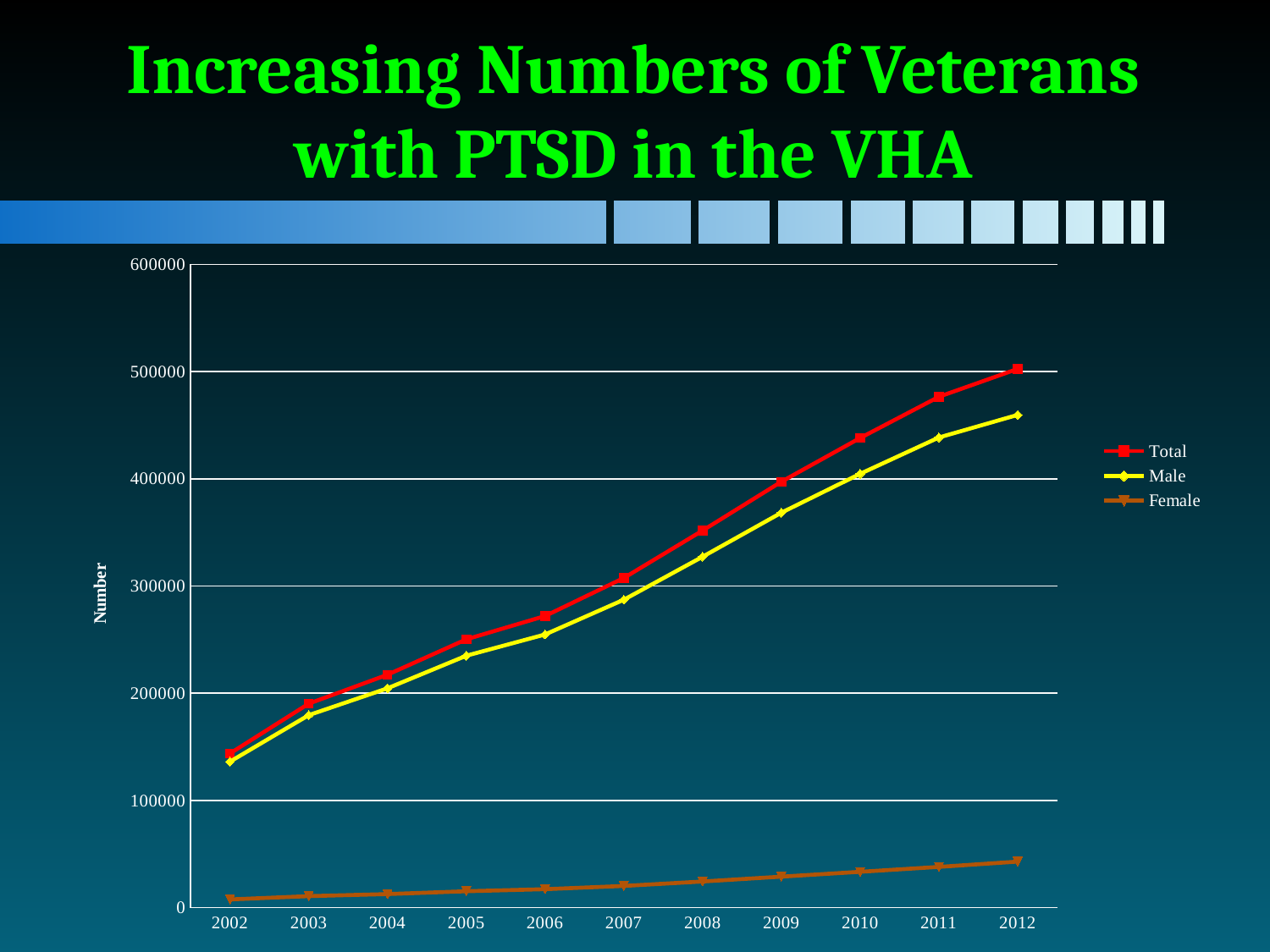
Does the Total series rise or fall from 2002 to 2012? rise Which series has the larger value in 2012, Male or Female? Male Is the value for Female in 2012 greater or less than 100000? less Is the value for Total in 2002 greater or less than 100000? greater What is the label on the y axis? Number In which year is the Total series at its highest? 2012 How many years are plotted along the x axis? 11 What kind of chart is shown on the slide? line chart How many series does the legend list? 3 Is the value for Male in 2012 greater or less than 500000? less In which year is the Male series at its lowest? 2002